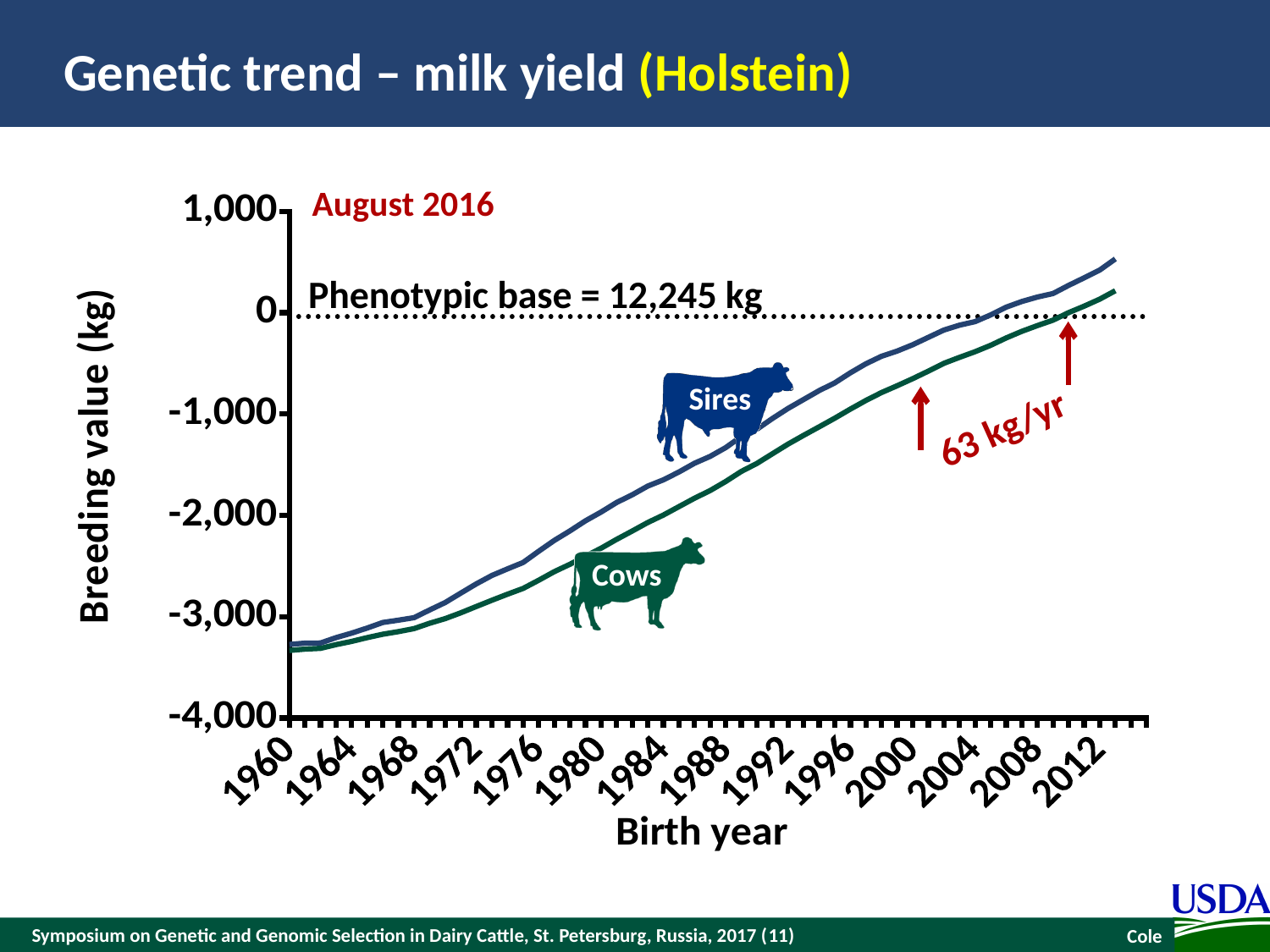
How many birth years are labeled on the x axis? 14 Is the breeding value for Sires born in 2000 greater or less than -1,000? greater How many series does the chart plot? 2 What kind of chart is shown on the slide? line chart Which series has the higher breeding value for birth year 1990, Sires or Cows? Sires Is the breeding value for Sires born in 1960 greater or less than -3,000? less Which series has the lower breeding value for birth year 2008, Sires or Cows? Cows Is the breeding value for Cows born in 1990 greater or less than -1,000? less Do the breeding values rise or fall as birth year increases? rise What phenotypic base is stated on the chart? 12,245 kg What are the names of the two series plotted on the chart? Sires and Cows